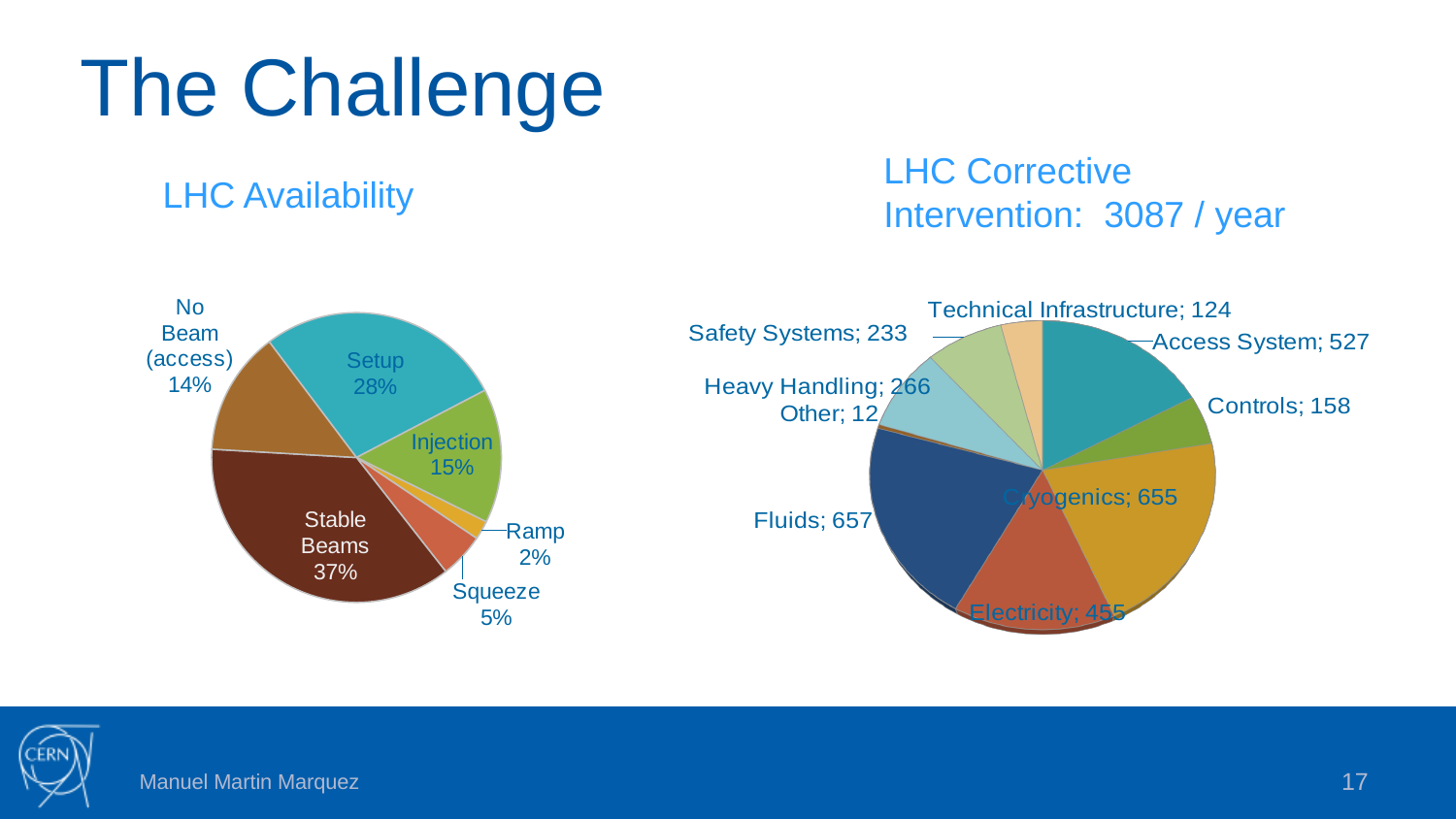
In the LHC Availability pie chart, which category has the largest share? Stable Beams In the LHC Availability pie chart, what is the difference in percentage points between Setup and Injection? 13 In the LHC Availability pie chart, which category has the smallest share? Ramp In the LHC Corrective Intervention pie chart, what is the difference between Cryogenics and Electricity? 200 In the LHC Availability pie chart, how many categories are shown? 6 In the LHC Corrective Intervention pie chart, which category has the smallest value? Other What type of chart is used for LHC Corrective Intervention? Pie chart In the LHC Availability pie chart, what percentage is shown for Stable Beams? 37% In the LHC Corrective Intervention pie chart, which is larger, Electricity or Safety Systems? Electricity In the LHC Corrective Intervention pie chart, what is the value for Heavy Handling? 266 In the LHC Availability pie chart, what percentage is shown for Setup? 28% In the LHC Corrective Intervention pie chart, what is the value for Access System? 527